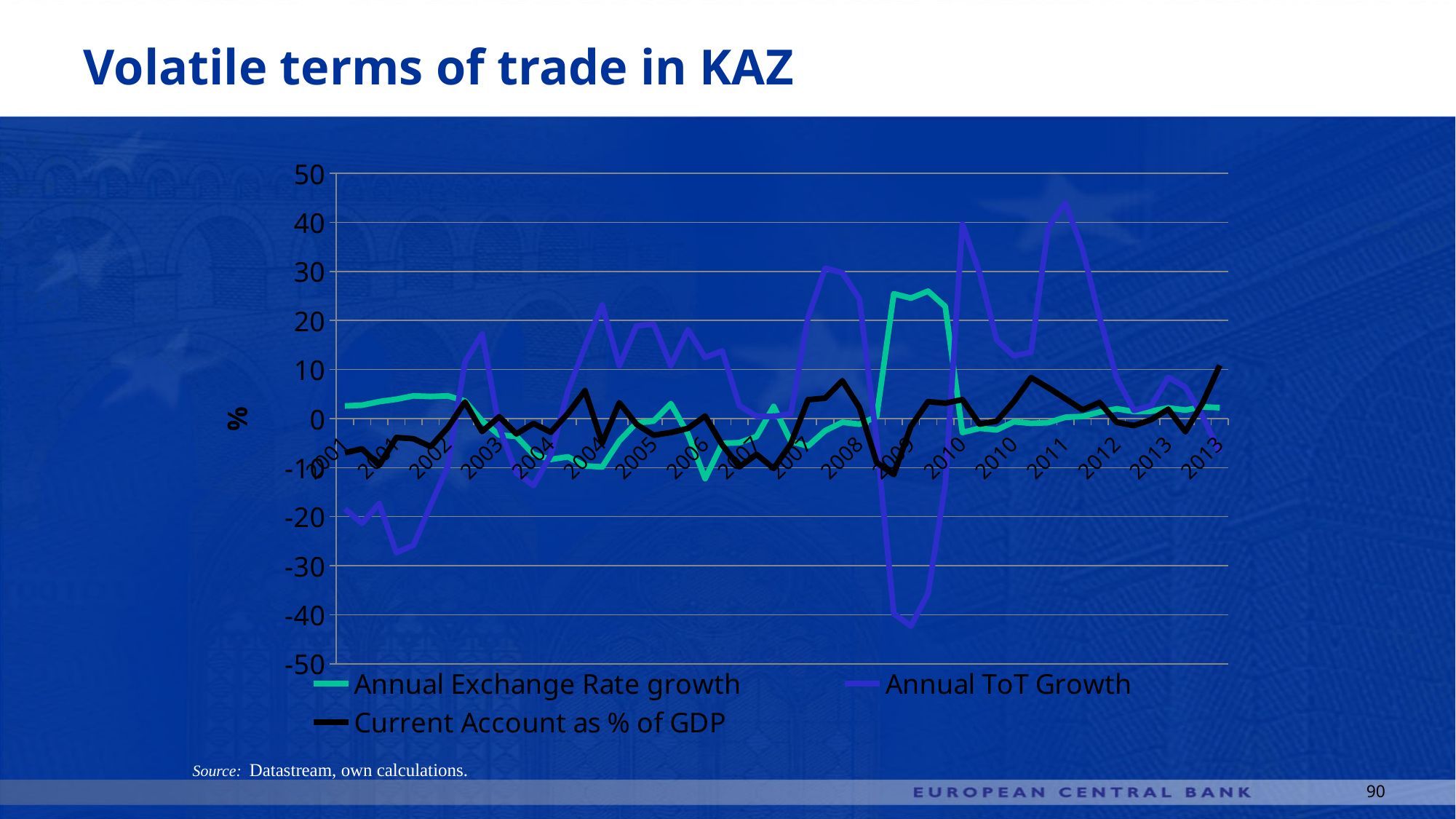
Is the lowest value of Annual ToT Growth around 2009 greater or less than -30? less What is the highest value shown on the vertical axis? 50 How many series does the legend list? 3 What label is shown on the vertical axis? % What kind of chart is shown on the slide? Line chart Which series reaches the highest value on the chart? Annual ToT Growth Which series reaches the lowest value on the chart? Annual ToT Growth Is the peak value of Annual Exchange Rate growth around 2009 greater or less than 20? greater Is the peak value of Annual ToT Growth around 2011 greater or less than 30? greater Around 2009, which is larger: Annual Exchange Rate growth or Annual ToT Growth? Annual Exchange Rate growth What is the title of the slide? Volatile terms of trade in KAZ